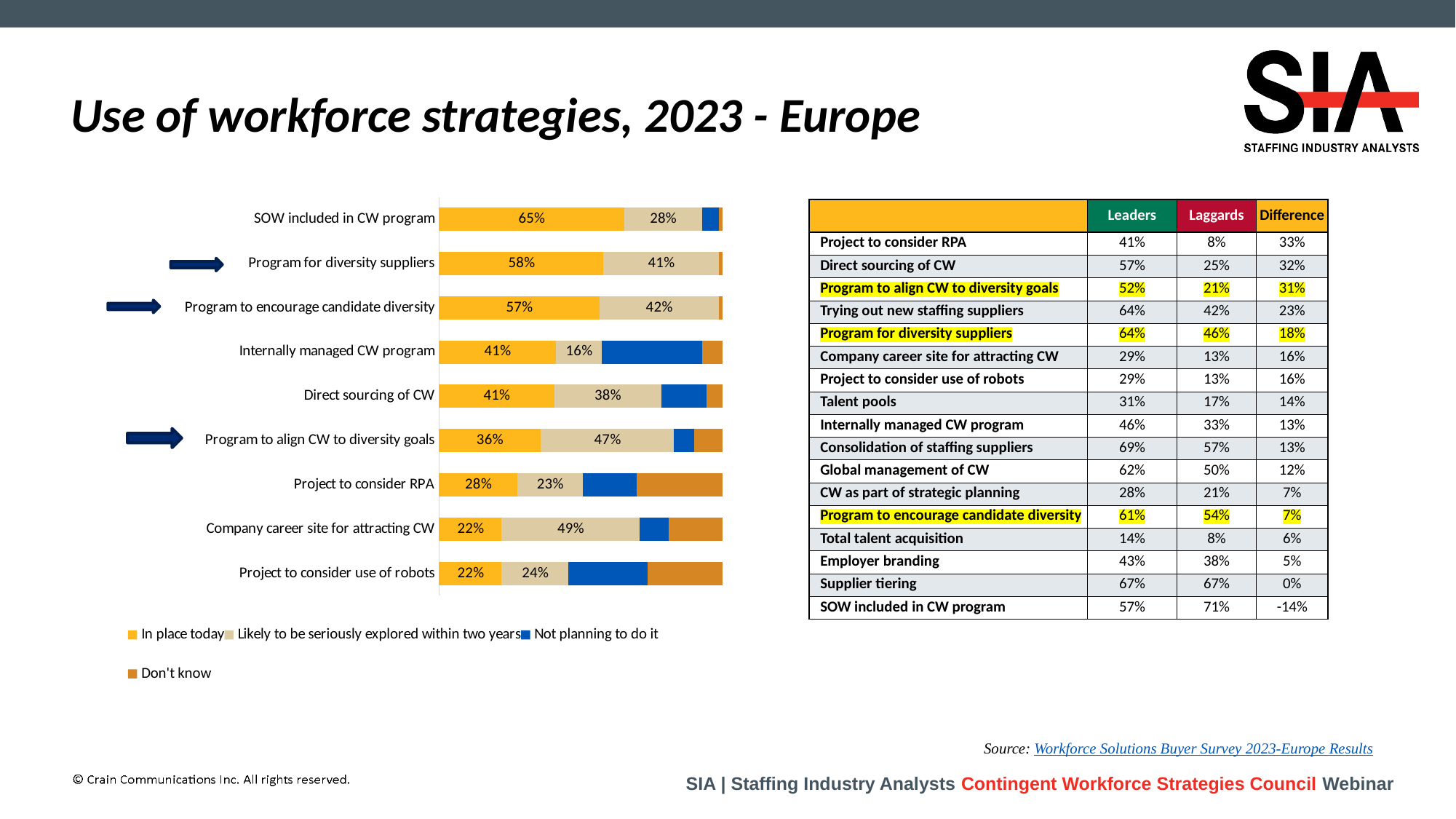
How many workforce strategies are shown in the bar chart? 9 Which has a higher 'In place today' value: 'Direct sourcing of CW' or 'Program to align CW to diversity goals'? Direct sourcing of CW Which strategy has the highest 'Likely to be seriously explored within two years' percentage? Company career site for attracting CW What is the 'Likely to be seriously explored within two years' value for 'Company career site for attracting CW'? 49% Which strategy has the highest 'In place today' percentage? SOW included in CW program How many series does the chart legend list? 4 What is the 'In place today' value for 'Project to consider RPA'? 28% Which strategy has the lowest 'Likely to be seriously explored within two years' percentage? Internally managed CW program For 'SOW included in CW program', what is the difference between the 'In place today' and 'Likely to be seriously explored within two years' values? 37 percentage points What percentage of respondents have 'SOW included in CW program' in place today? 65% For 'Program for diversity suppliers', what is the combined total of 'In place today' and 'Likely to be seriously explored within two years'? 99% What type of chart is used to show the use of workforce strategies? Stacked bar chart